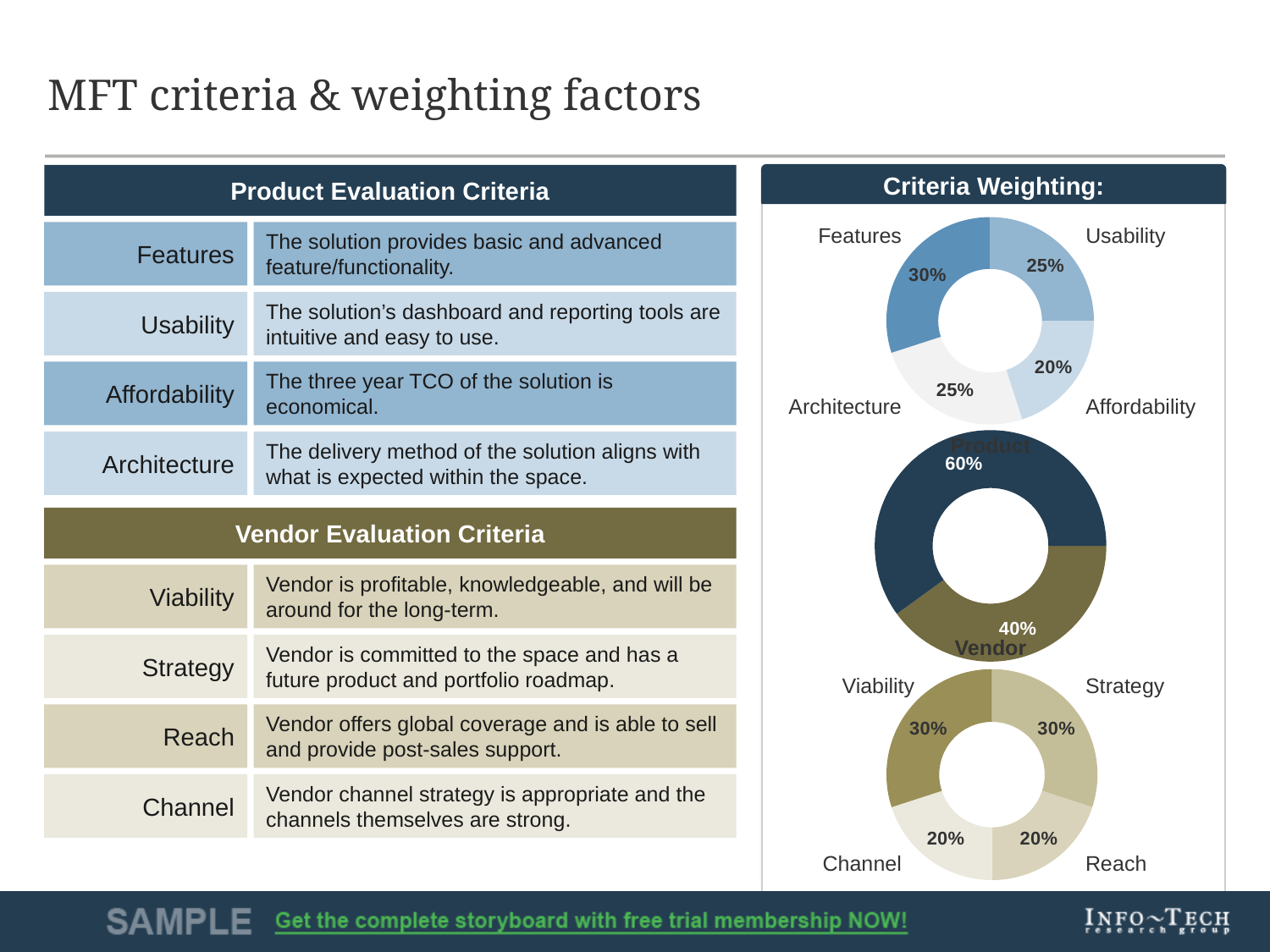
In the middle donut chart under Criteria Weighting, which is larger, Product or Vendor? Product In the bottom donut chart under Criteria Weighting, how many criteria are shown? 4 In the bottom donut chart under Criteria Weighting, what is the difference between the Viability and Channel weightings? 10% In the top donut chart under Criteria Weighting, what is the weighting for Features? 30% What kind of chart is used to show the Criteria Weighting? Donut chart In the top donut chart under Criteria Weighting, which criterion has the lowest weighting? Affordability In the top donut chart under Criteria Weighting, which criterion has the highest weighting? Features In the bottom donut chart under Criteria Weighting, what is the weighting for Reach? 20% In the top donut chart under Criteria Weighting, what is the weighting for Affordability? 20% In the middle donut chart under Criteria Weighting, what is the weighting for Product? 60% In the top donut chart under Criteria Weighting, how many criteria are shown? 4 In the middle donut chart under Criteria Weighting, what is the difference between the Product and Vendor weightings? 20%